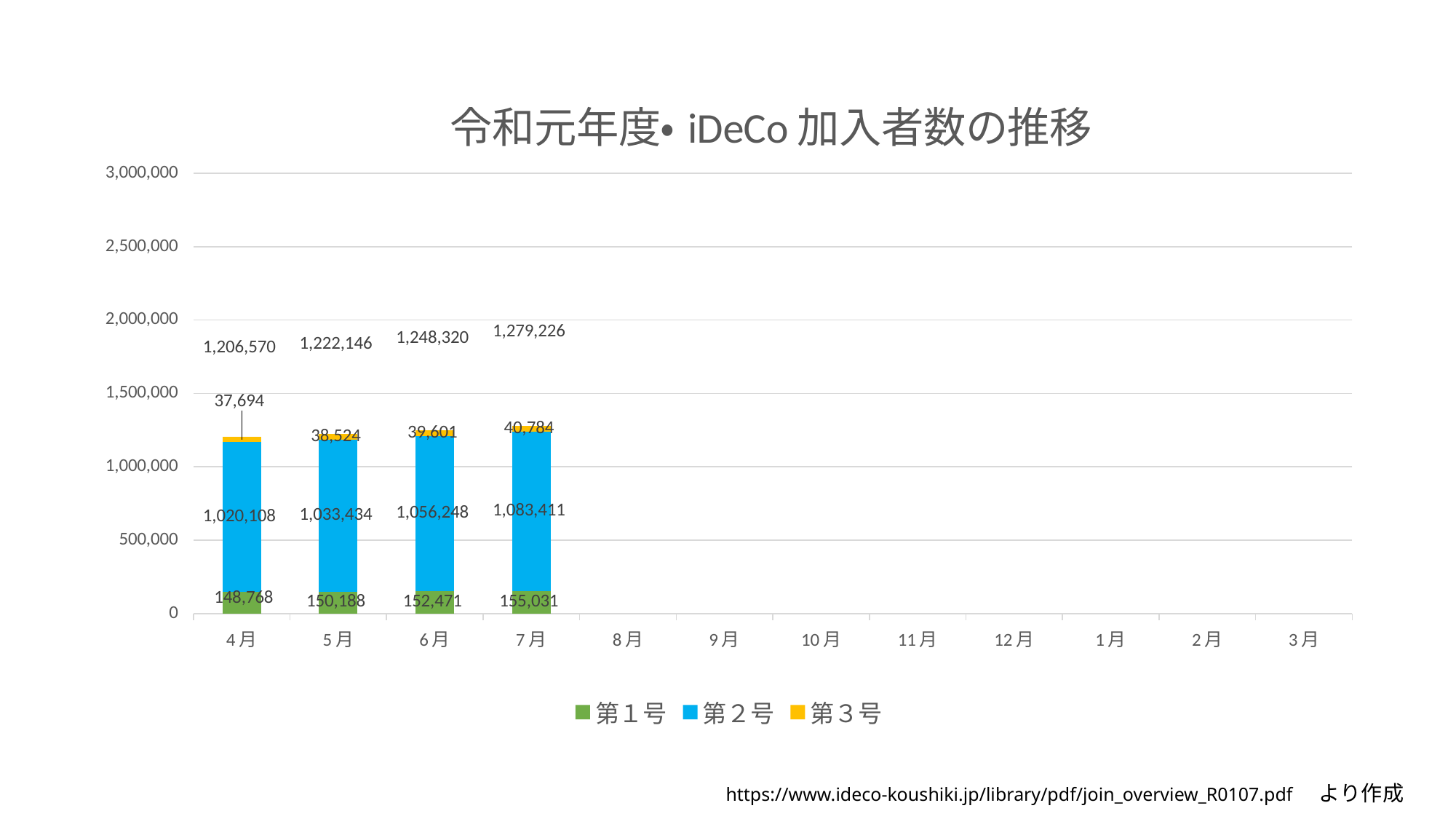
What is the value for 第１号 in 6月? 152,471 What is the value for 第３号 in 7月? 40,784 Which is larger, the 第３号 value in 5月 or in 6月? 6月 How many series does the legend list? 3 What is the total of the stacked bar for 5月? 1,222,146 What is the difference between the 第２号 value in 7月 and in 4月? 63,303 How many months have bars plotted on the chart? 4 Do the total values rise or fall from 4月 to 7月? rise Which month has the highest total number of iDeCo participants? 7月 What is the value for 第２号 in 4月? 1,020,108 Is the value for 第２号 in 6月 greater or less than 1,000,000? greater Which month has the lowest value for 第１号? 4月